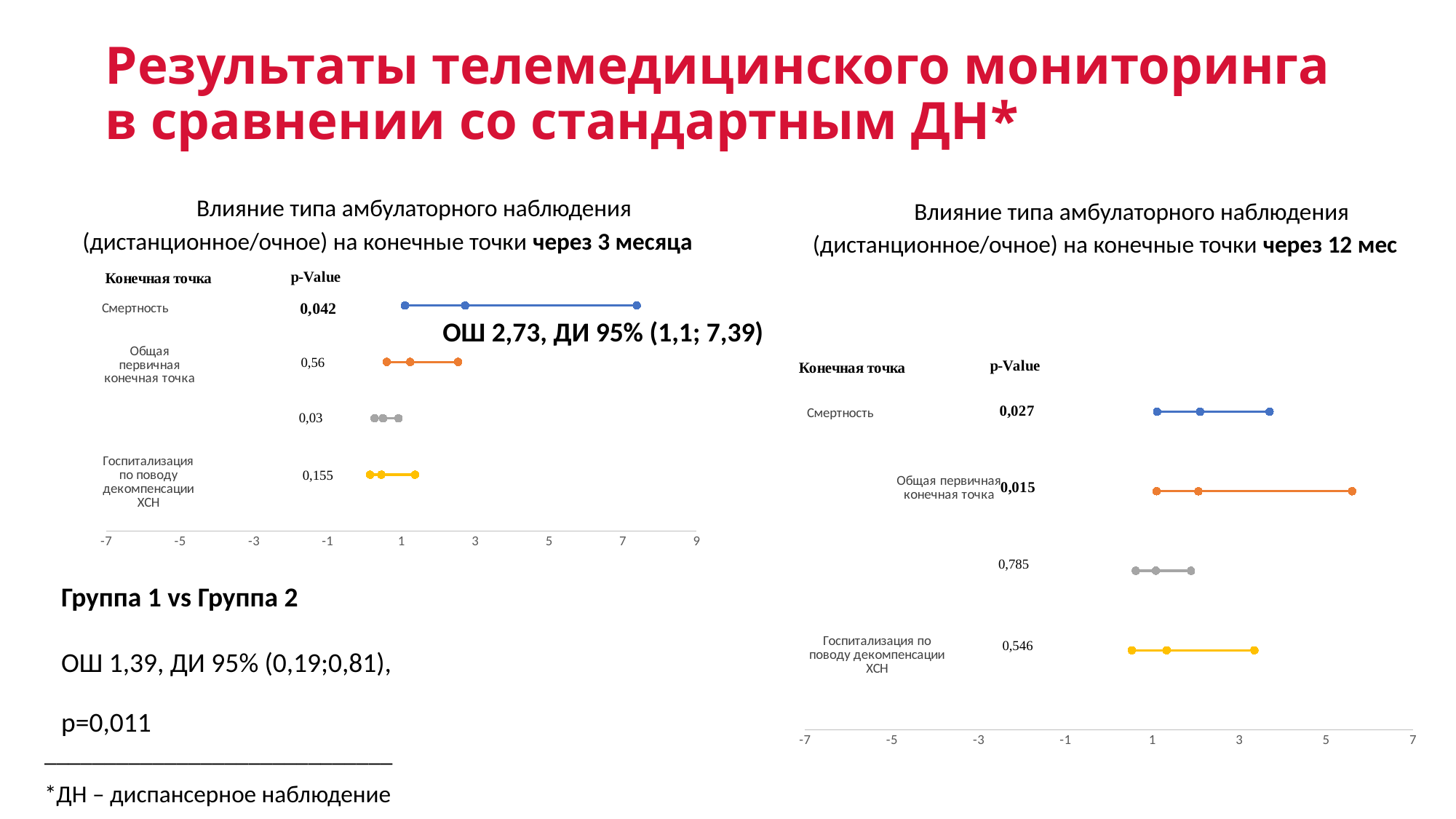
On the left chart (через 3 месяца), which has the larger p-Value: Смертность or Госпитализация по поводу декомпенсации ХСН? Госпитализация по поводу декомпенсации ХСН How many endpoint rows (confidence interval lines) are plotted on the right chart (через 12 мес)? 4 On the left chart (через 3 месяца), what is the p-Value for Госпитализация по поводу декомпенсации ХСН? 0,155 On the right chart (через 12 мес), what is the p-Value for Общая первичная конечная точка? 0,015 On the right chart (через 12 мес), is the upper confidence limit for Общая первичная конечная точка greater or less than 5? greater On the right chart (через 12 мес), what is the p-Value for Смертность? 0,027 On the left chart (через 3 месяца), which endpoint has the highest upper confidence limit on the x axis? Смертность On the right chart (через 12 мес), which endpoint has the highest upper confidence limit on the x axis? Общая первичная конечная точка On the right chart (через 12 мес), what is the p-Value for Госпитализация по поводу декомпенсации ХСН? 0,546 On the left chart (через 3 месяца), what odds ratio and 95% confidence interval are annotated for Смертность? ОШ 2,73, ДИ 95% (1,1; 7,39) On the left chart (через 3 месяца), what is the p-Value for Смертность? 0,042 On the left chart (через 3 месяца), what is the p-Value for Общая первичная конечная точка? 0,56